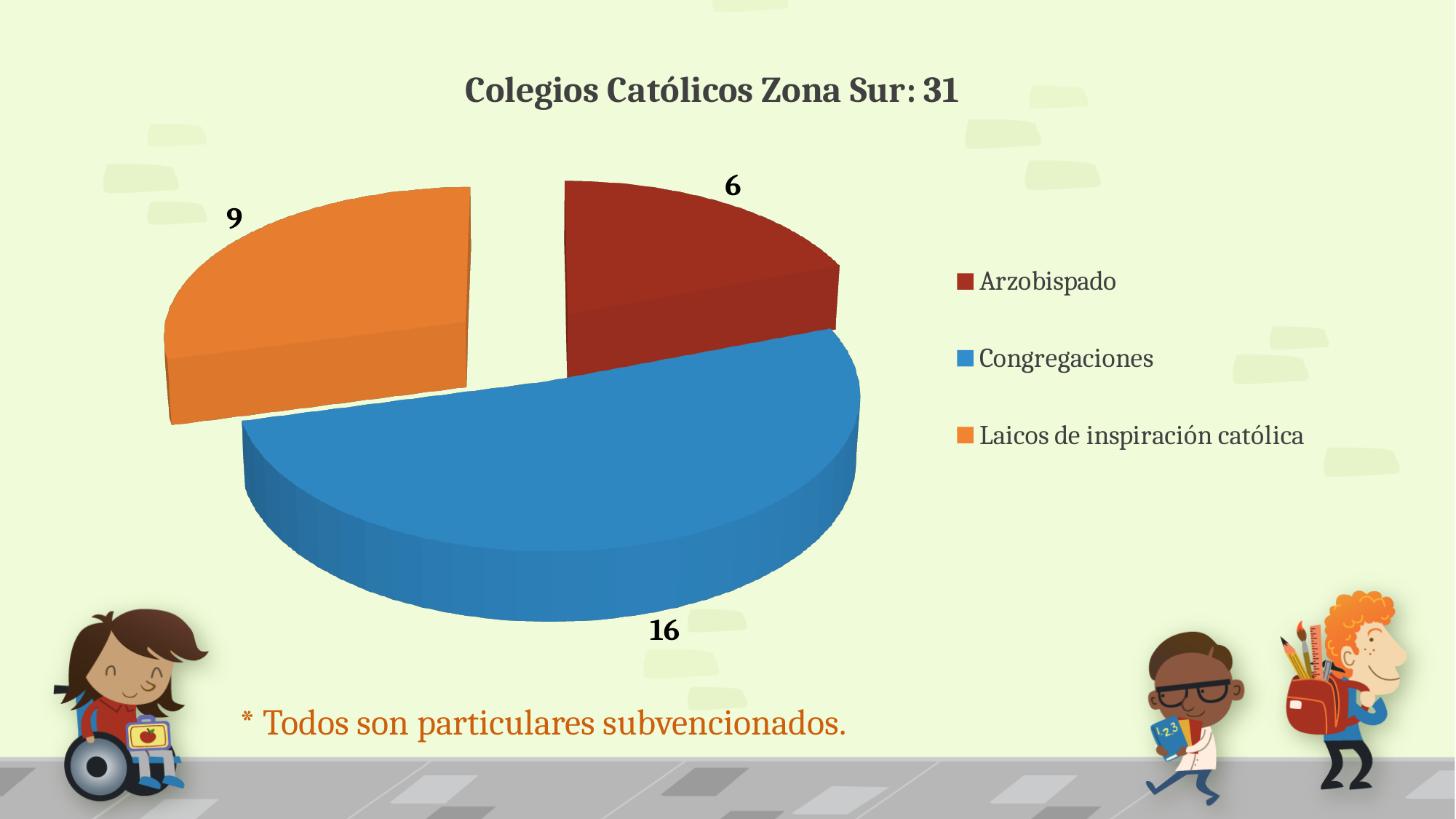
What is the value for Laicos de inspiración católica? 9 Which colour represents Congregaciones in the legend? Blue What is the value for Congregaciones? 16 How many slices does the pie chart have? 3 Which category has the smallest slice? Arzobispado What is the value for Arzobispado? 6 What is the title of the chart? Colegios Católicos Zona Sur: 31 What is the difference between the values for Congregaciones and Laicos de inspiración católica? 7 What kind of chart is shown on the slide? Pie chart Which is larger, Laicos de inspiración católica or Arzobispado? Laicos de inspiración católica What is the total of all slices in the pie chart? 31 Which category has the largest slice? Congregaciones